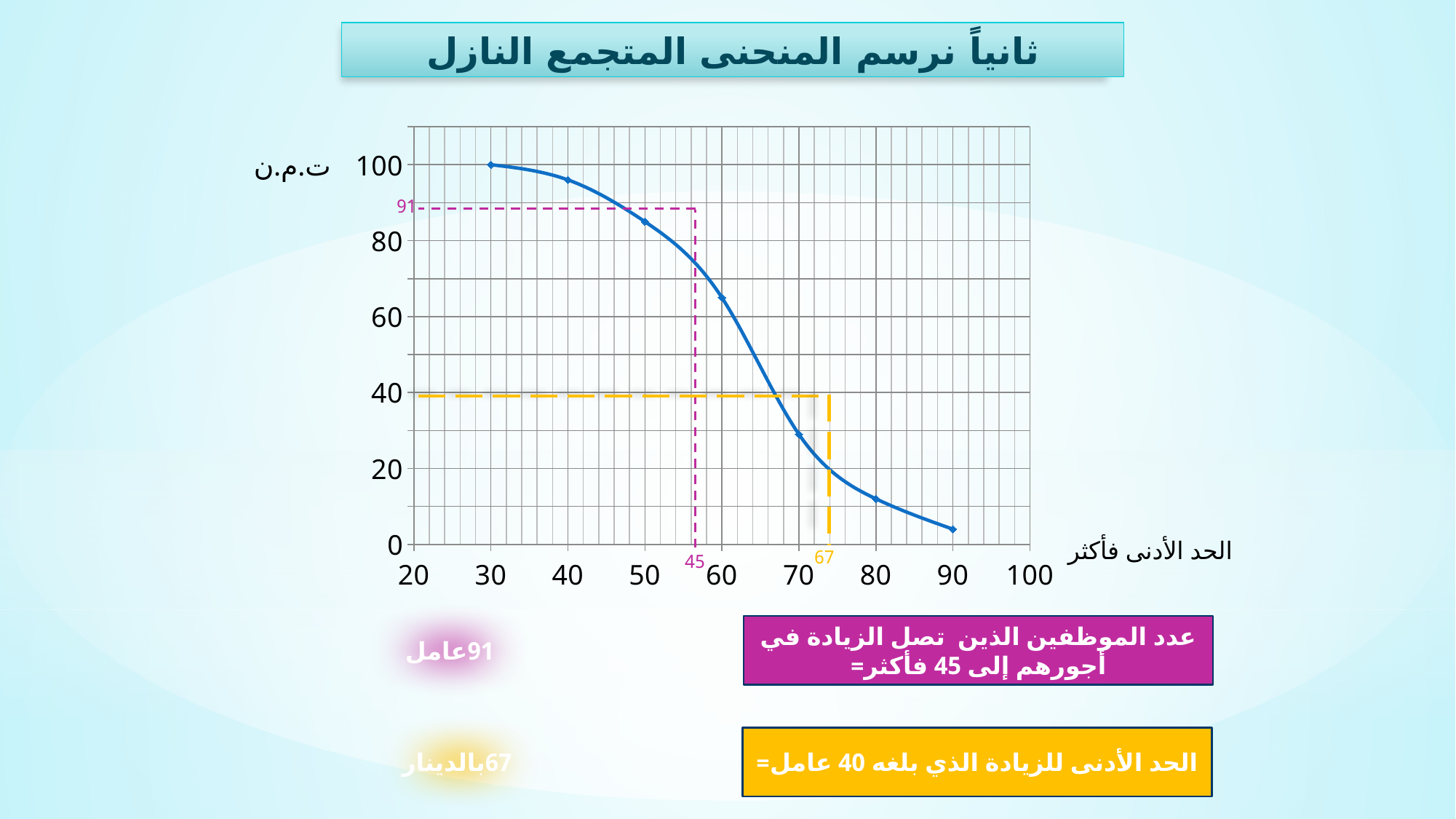
What is the title of the chart on the slide? ثانياً نرسم المنحنى المتجمع النازل How many data points are plotted on the curve? 7 Which has the larger plotted value, x = 50 or x = 70? 50 Is the plotted value at x = 50 greater or less than 80? greater What is the plotted value at x = 30? 100 What kind of chart is shown on the slide? line chart Is the plotted value at x = 80 greater or less than 20? less At which x value is the plotted value lowest? 90 Is the plotted value at x = 70 greater or less than 40? less At which x value is the plotted value highest? 30 According to the dashed annotation, what cumulative value is read off the curve at x = 45? 91 Do the values rise or fall as you move from left to right along the x axis? fall